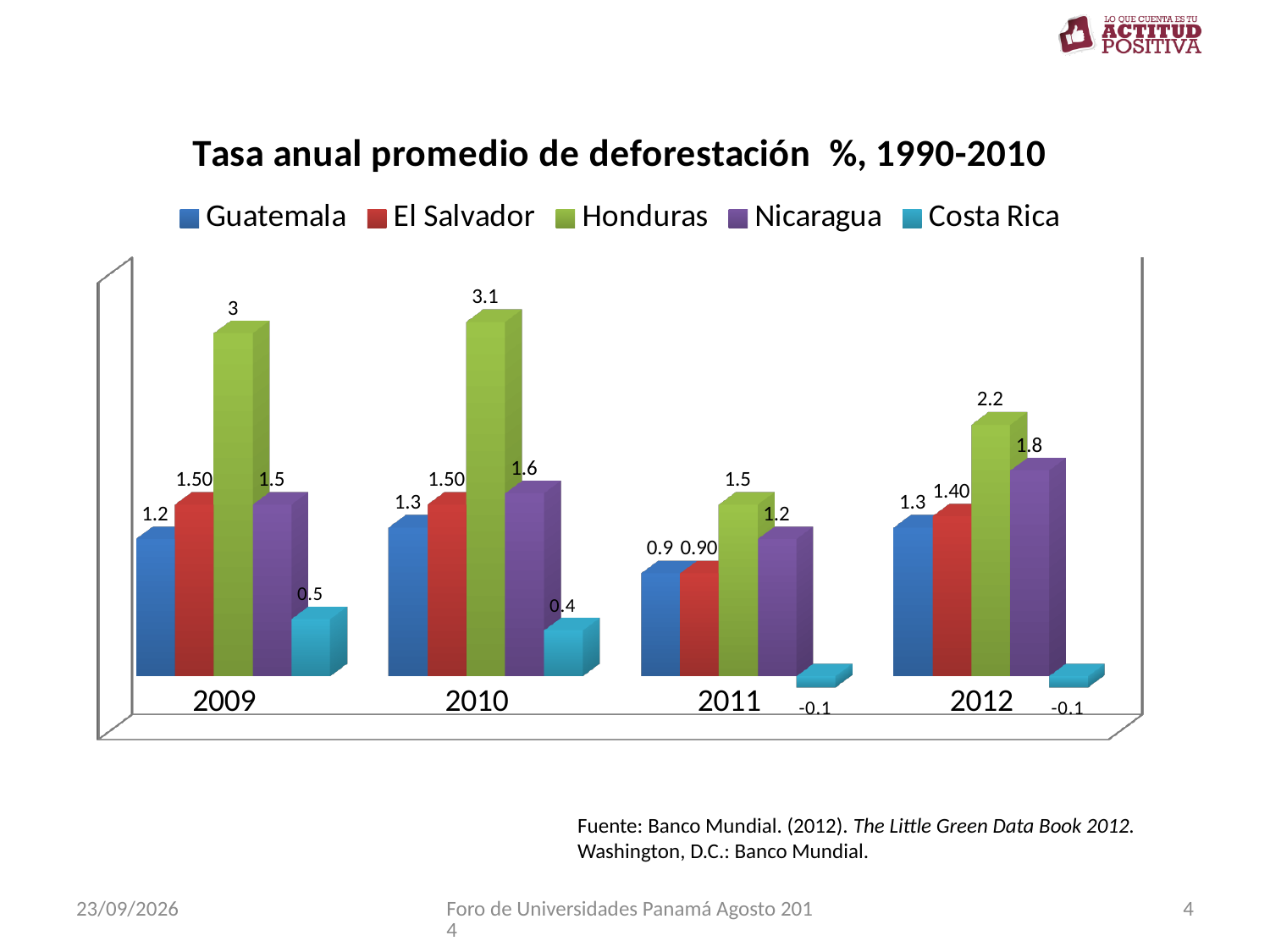
What is the title of the chart? Tasa anual promedio de deforestación %, 1990-2010 What is the value for Costa Rica in 2009? 0.5 How many series does the legend list? 5 What is the value for Honduras in 2010? 3.1 Which is larger, the Nicaragua value in 2012 or the Nicaragua value in 2009? Nicaragua in 2012 What is the value for El Salvador in 2012? 1.40 What is the value for Nicaragua in 2011? 1.2 Which country has the highest value in 2009? Honduras How many years are shown on the x axis? 4 What kind of chart is shown? Bar chart Which country has the lowest value in 2012? Costa Rica What is the difference between the Honduras values in 2010 and 2012? 0.9